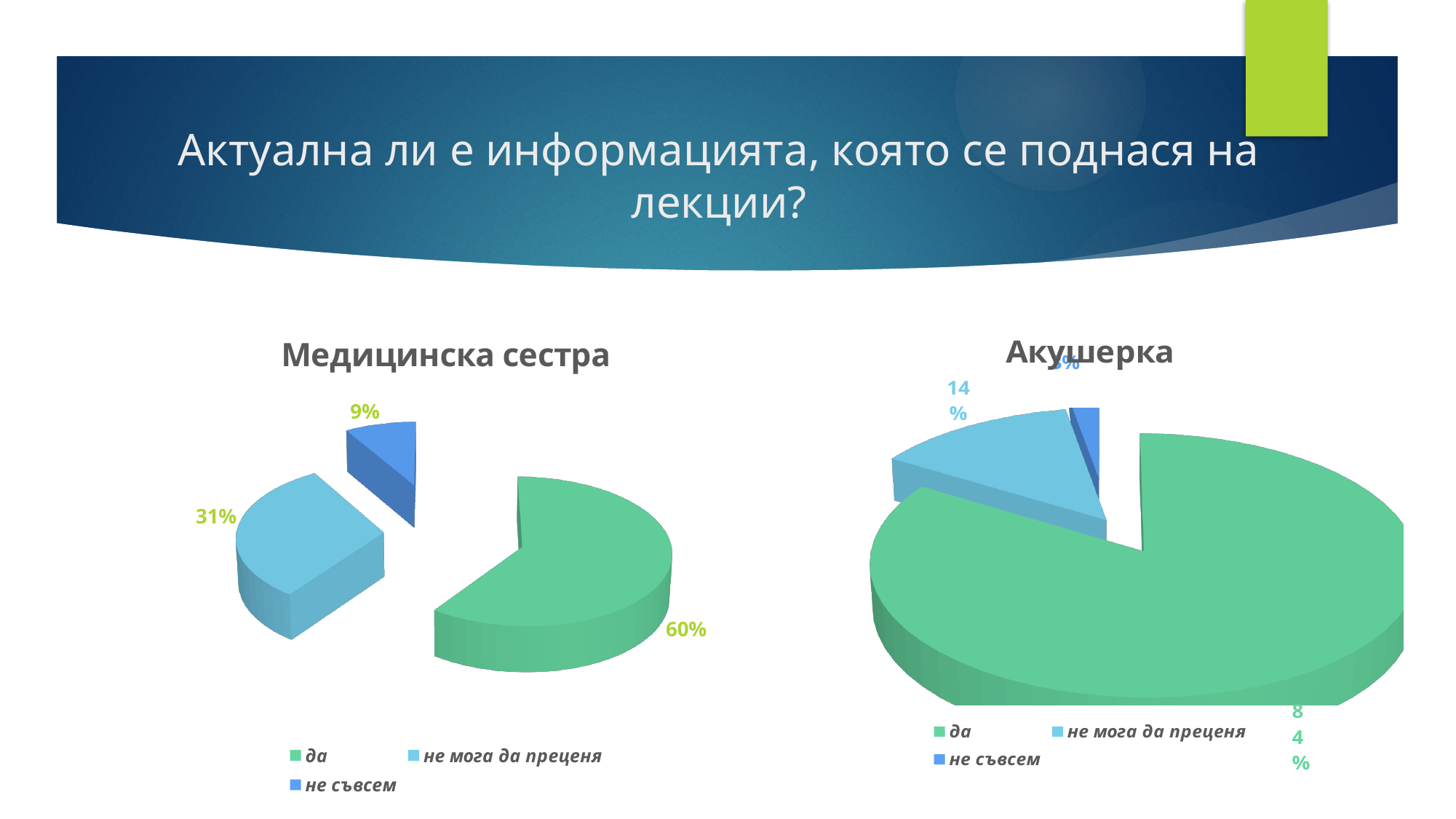
In the "Медицинска сестра" chart, what is the share for "не мога да преценя"? 31% In the "Медицинска сестра" chart, what is the difference between the "да" and "не мога да преценя" shares? 29% In the "Акушерка" chart, what is the share for "не мога да преценя"? 14% In the "Медицинска сестра" chart, what is the share for "да"? 60% In the "Медицинска сестра" chart, which category has the smallest slice? не съвсем In the "Медицинска сестра" chart, which category has the largest slice? да In the "Акушерка" chart, what is the share for "да"? 84% How many categories does the legend of the "Акушерка" chart list? 3 Which chart has the larger share for "да", "Медицинска сестра" or "Акушерка"? Акушерка What kind of chart is the "Медицинска сестра" chart? pie chart In the "Медицинска сестра" chart, what is the share for "не съвсем"? 9% In the "Акушерка" chart, which category has the largest slice? да